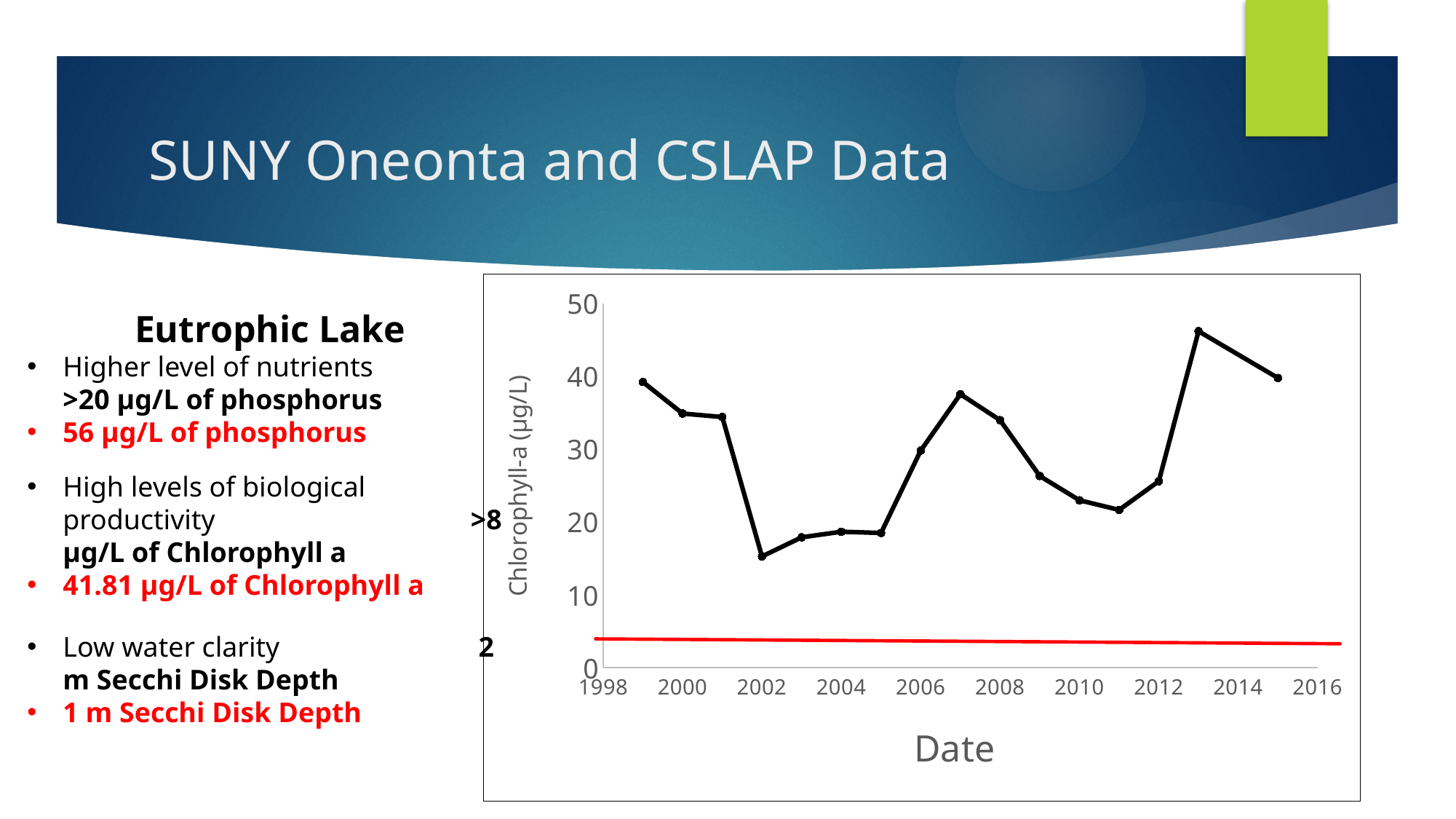
In which year is the chlorophyll-a value lowest? 2002 Is the chlorophyll-a value for 2013 greater or less than 40? greater Is the chlorophyll-a value for 2010 greater or less than 30? less In which year is the chlorophyll-a value highest? 2013 Is the chlorophyll-a value for 1999 greater or less than 30? greater Does the chlorophyll-a value rise or fall from 1999 to 2002? fall Does the chlorophyll-a value rise or fall from 2011 to 2013? rise Which year has the higher chlorophyll-a value, 2007 or 2011? 2007 What kind of chart is shown on the slide? line chart What is the label of the vertical axis of the chart? Chlorophyll-a (µg/L) What is the label of the horizontal axis of the chart? Date